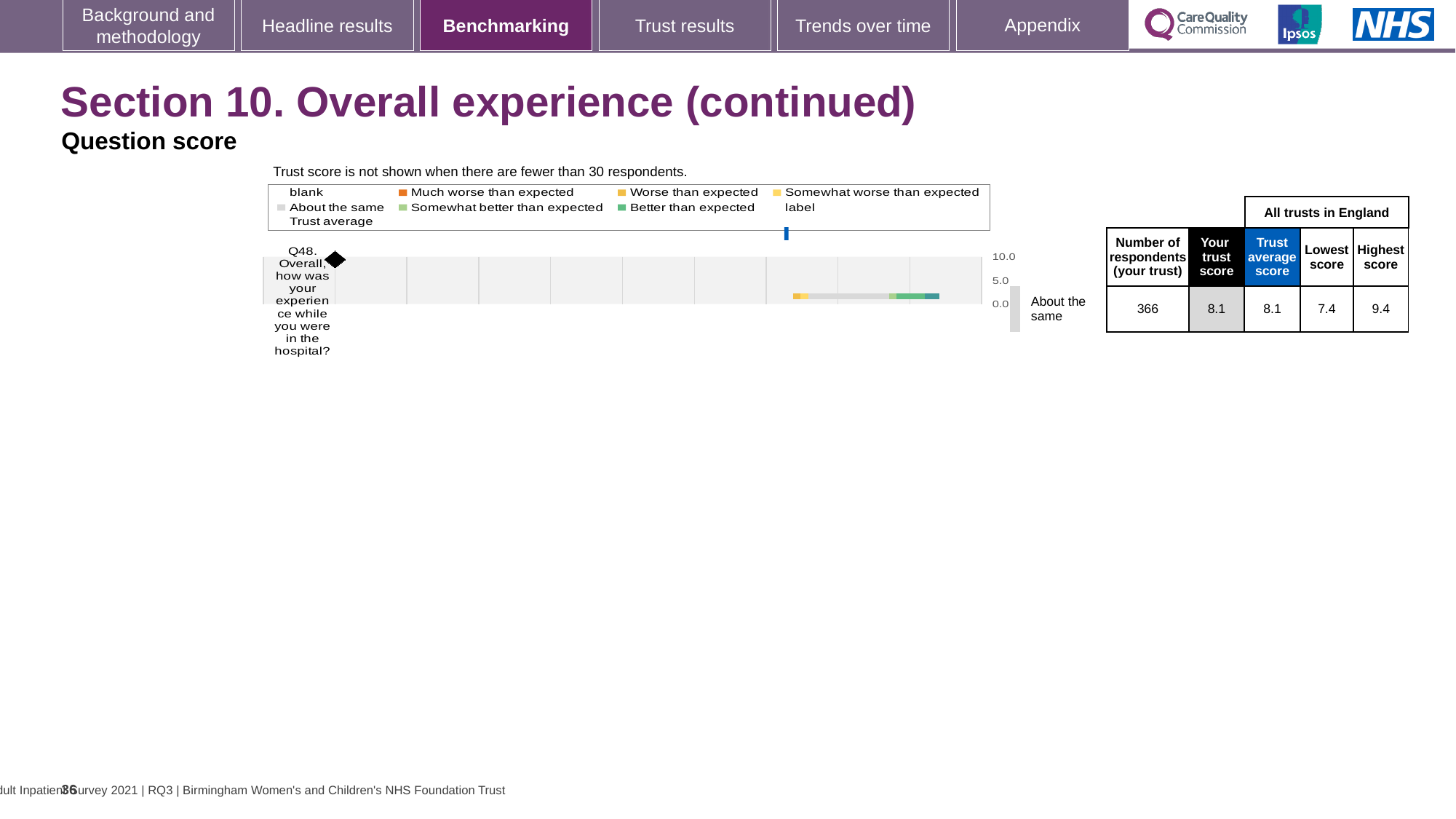
In the table beside the chart, what is the lowest score among all trusts in England for Q48? 7.4 Is your trust score for Q48 greater or less than 5.0? greater What is the difference between the highest score and your trust score for Q48 in the table beside the chart? 1.3 In the table beside the chart, what is your trust score for Q48? 8.1 What kind of chart is used to show the Q48 question score? bar chart In the table beside the chart, what is the highest score among all trusts in England for Q48? 9.4 What is the difference between the highest score and the lowest score for Q48 in the table beside the chart? 2.0 In the table beside the chart, what is the trust average score for Q48? 8.1 Which question number is plotted in the chart? Q48 How many questions are plotted in the chart? 1 In the table beside the chart, what is the number of respondents for your trust for Q48? 366 What benchmark category is shown for Q48 next to the chart? About the same